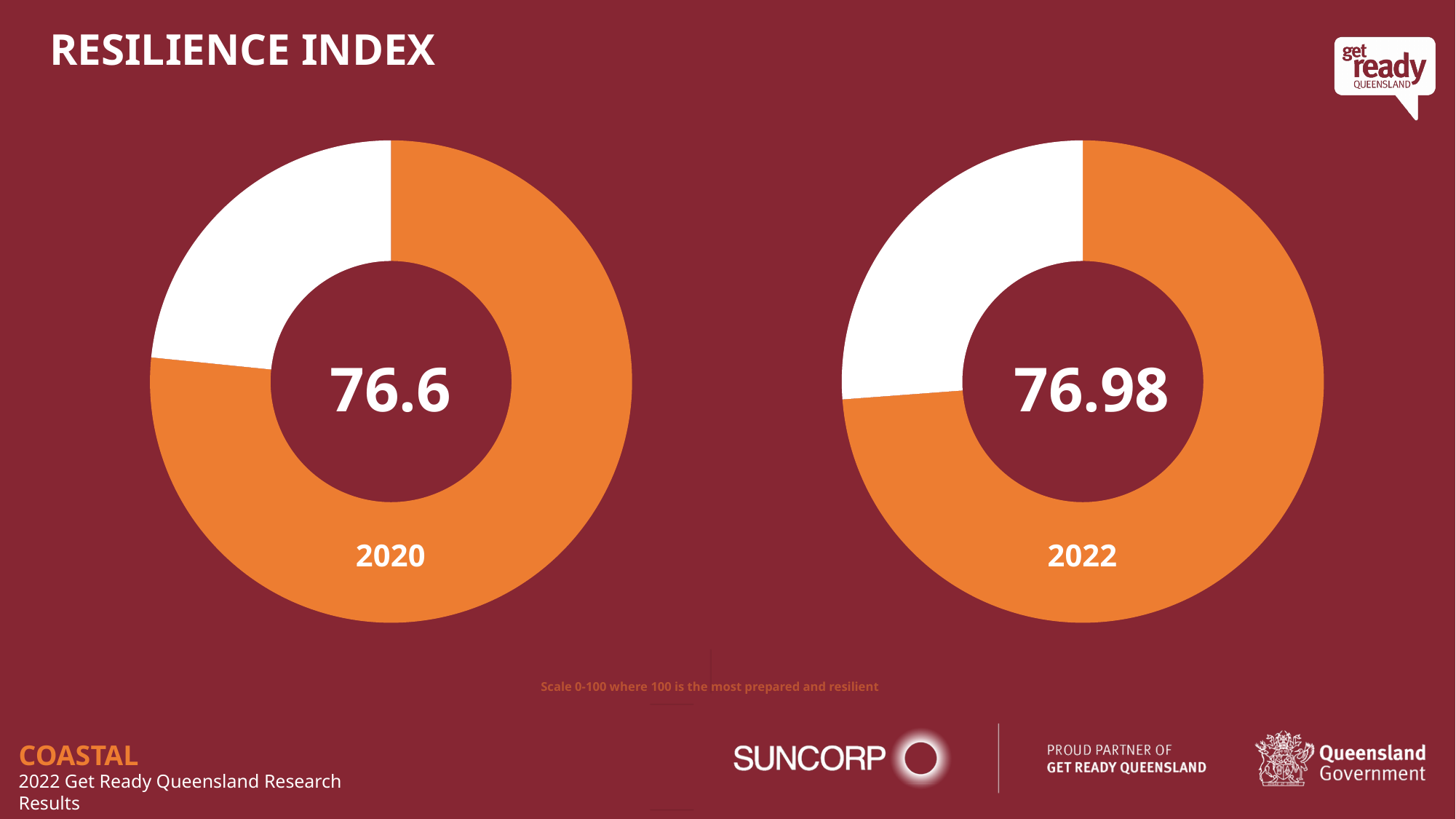
How many donut charts are shown on the slide? 2 What is the difference between the 2022 Resilience Index value and the 2020 value? 0.38 What is the Resilience Index value shown in the 2020 donut chart? 76.6 Which year's chart shows the highest Resilience Index value? 2022 What is the Resilience Index value shown in the 2022 donut chart? 76.98 Did the Resilience Index rise or fall from the 2020 chart to the 2022 chart? rise Which year's chart shows the lowest Resilience Index value? 2020 What kind of chart is used to show the 2020 Resilience Index? donut chart In the 2020 donut chart, what share of the 0-100 scale does the orange segment represent? 76.6 According to the note below the charts, what scale is the Resilience Index measured on? 0-100 What is the title of the slide containing the two donut charts? RESILIENCE INDEX Which year's chart shows the higher Resilience Index, 2020 or 2022? 2022